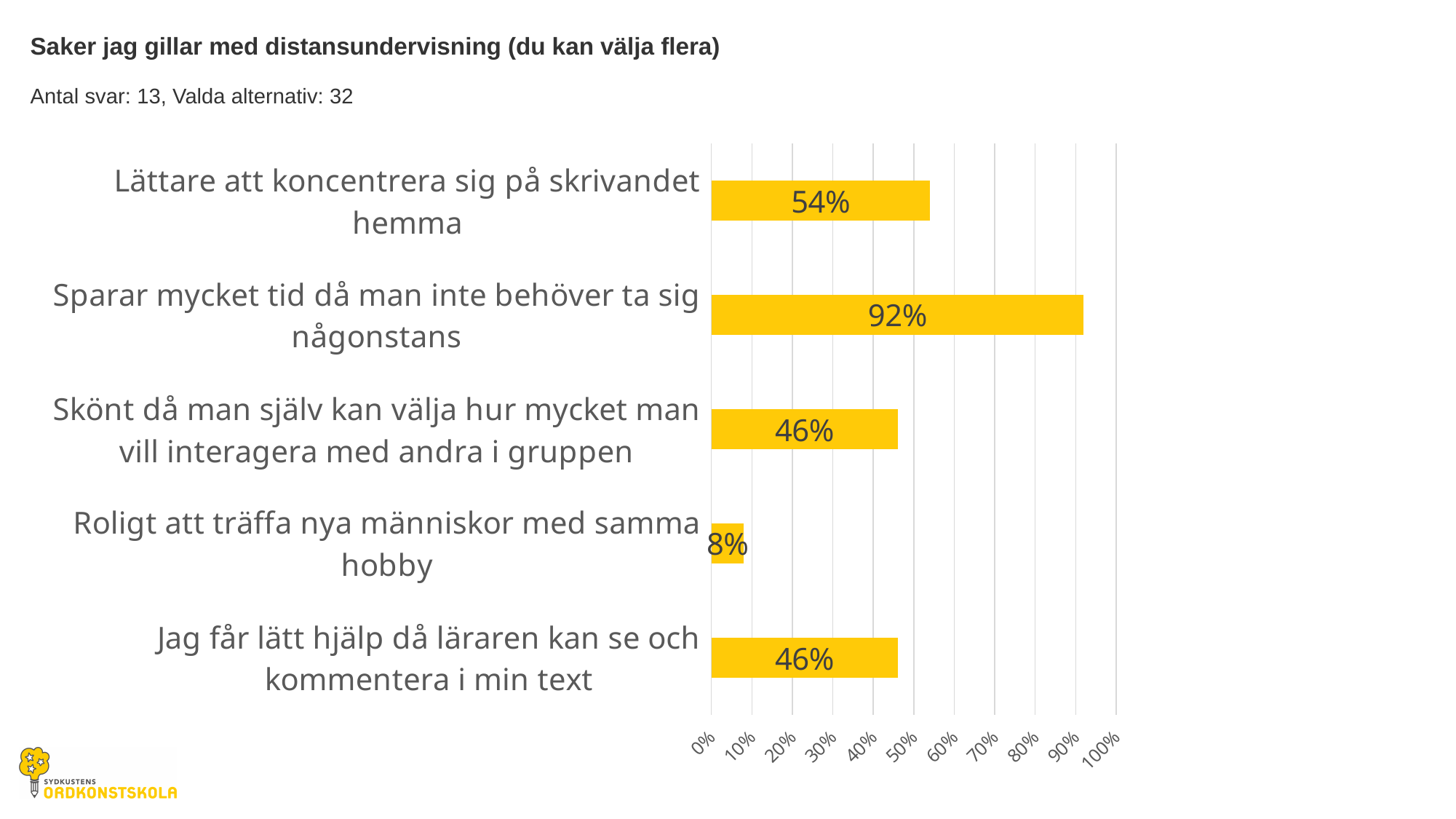
What is the title of the chart? Saker jag gillar med distansundervisning (du kan välja flera) What kind of chart is shown on the slide? Bar chart What percentage is shown for "Roligt att träffa nya människor med samma hobby"? 8% Which is larger: the value for "Lättare att koncentrera sig på skrivandet hemma" or for "Skönt då man själv kan välja hur mycket man vill interagera med andra i gruppen"? Lättare att koncentrera sig på skrivandet hemma What percentage is shown for "Jag får lätt hjälp då läraren kan se och kommentera i min text"? 46% Which category has the lowest percentage? Roligt att träffa nya människor med samma hobby What percentage is shown for "Lättare att koncentrera sig på skrivandet hemma"? 54% What is the difference in percentage points between "Sparar mycket tid då man inte behöver ta sig någonstans" and "Lättare att koncentrera sig på skrivandet hemma"? 38 percentage points Which category has the highest percentage? Sparar mycket tid då man inte behöver ta sig någonstans How many categories are shown in the chart? 5 Is the value for "Sparar mycket tid då man inte behöver ta sig någonstans" greater or less than 80%? greater What percentage is shown for "Sparar mycket tid då man inte behöver ta sig någonstans"? 92%